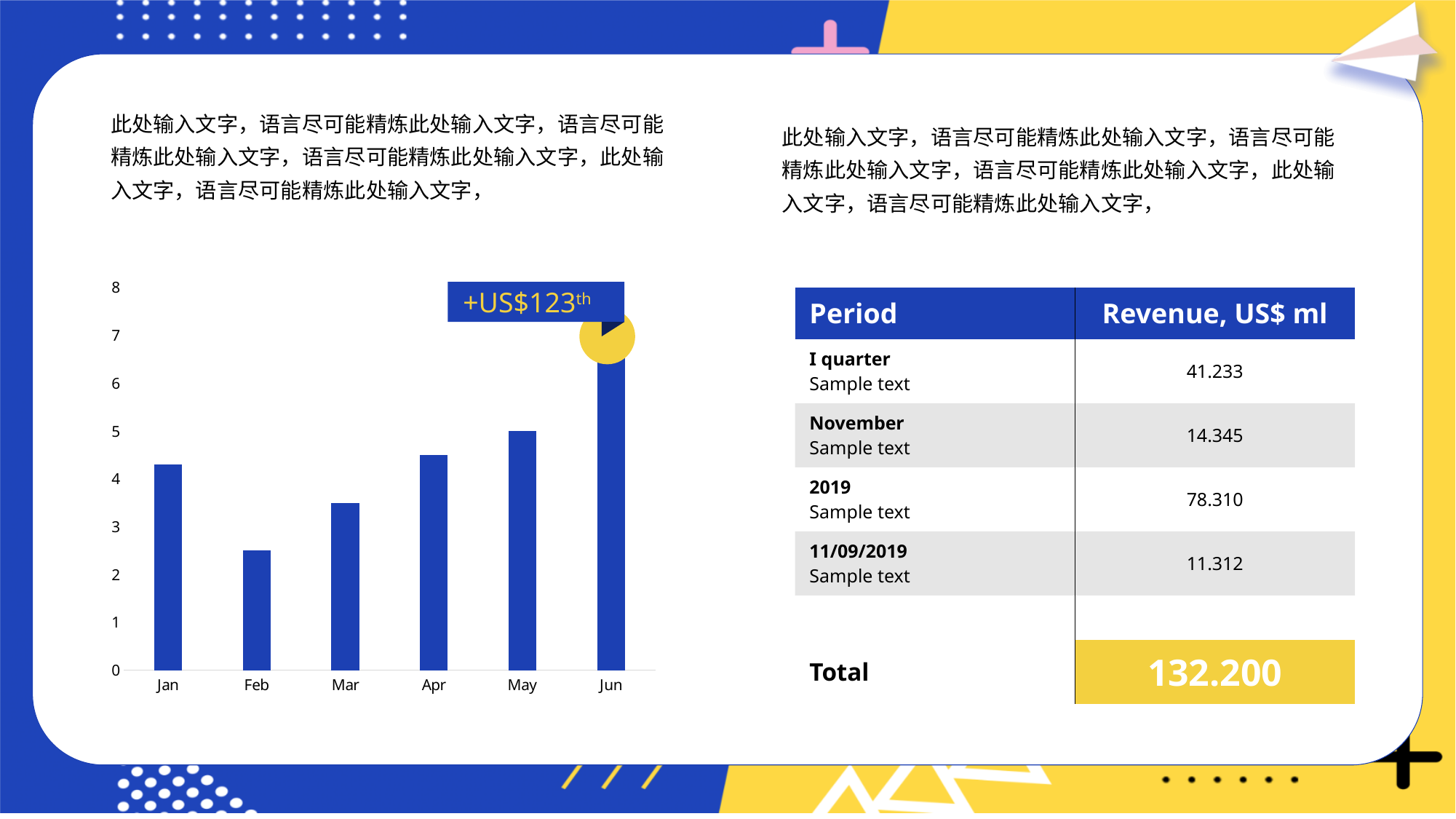
What kind of chart is shown on the left of the slide? bar chart Is the value for Mar greater or less than 4? less Which month has the highest bar in the chart? Jun Which month has the lowest bar in the chart? Feb What text is shown in the callout above the Jun bar? +US$123th Is the value for Apr greater or less than 4? greater Which is larger in the bar chart, the value for Jan or the value for Feb? Jan Is the value for Feb greater or less than 3? less How many months are shown on the x axis of the bar chart? 6 From Feb to Jun, do the bar values rise or fall? rise Which is larger in the bar chart, the value for May or the value for Mar? May